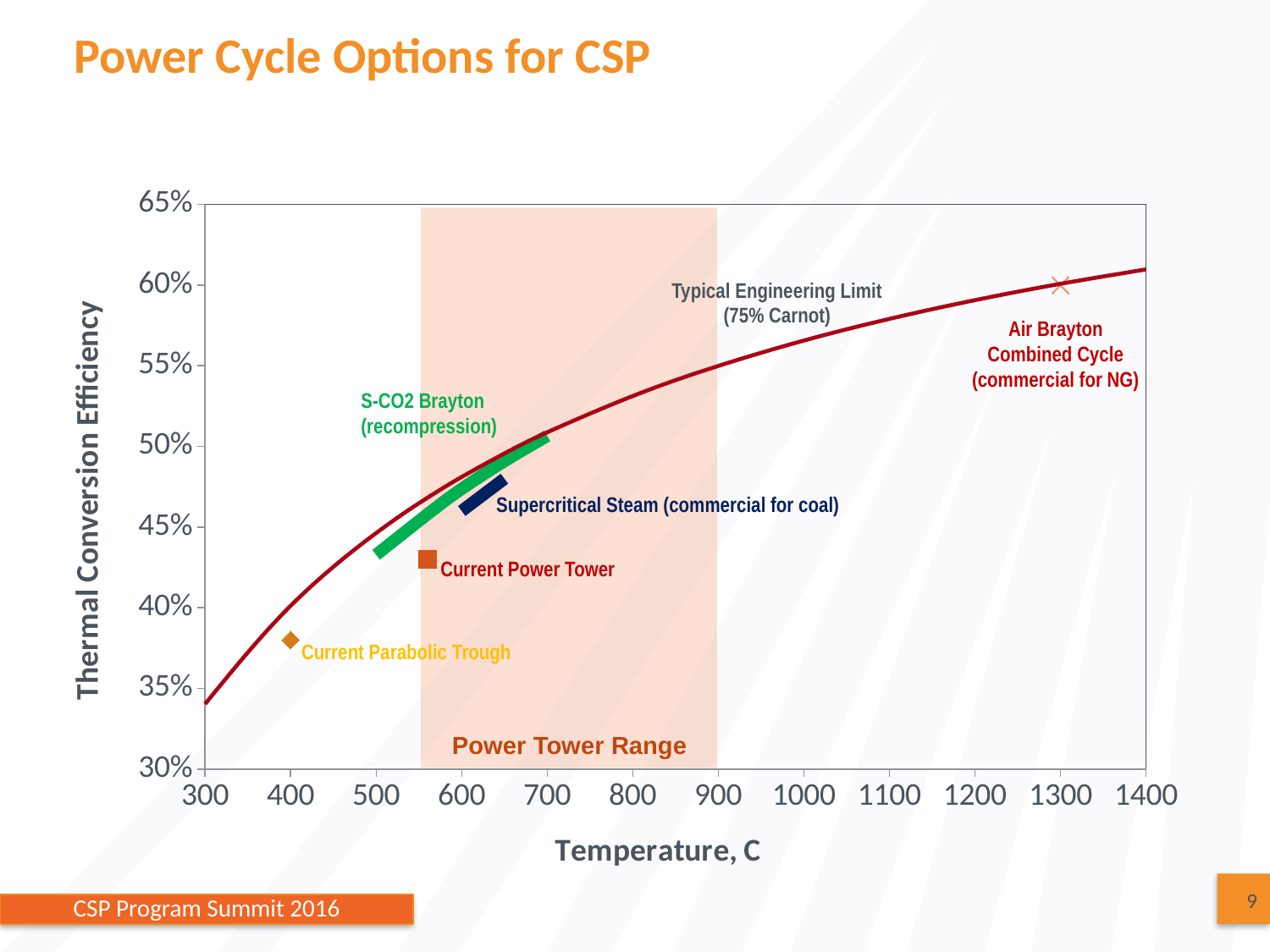
What thermal conversion efficiency is shown for the Air Brayton Combined Cycle point? 60% Which labeled technology has the highest thermal conversion efficiency on the chart? Air Brayton Combined Cycle Is the thermal conversion efficiency for Current Power Tower greater or less than 45%? less What is the title of the chart's slide? Power Cycle Options for CSP Does the Typical Engineering Limit (75% Carnot) curve rise or fall as temperature increases? Rises At what temperature is the Current Parabolic Trough point plotted? 400 What is the label of the y axis? Thermal Conversion Efficiency At what temperature is the Air Brayton Combined Cycle point plotted? 1300 What kind of chart is shown on the slide? Line chart with scatter points Which labeled technology has the lowest thermal conversion efficiency on the chart? Current Parabolic Trough Which has the higher thermal conversion efficiency, Current Power Tower or Current Parabolic Trough? Current Power Tower Is the thermal conversion efficiency for Current Parabolic Trough greater or less than 40%? less